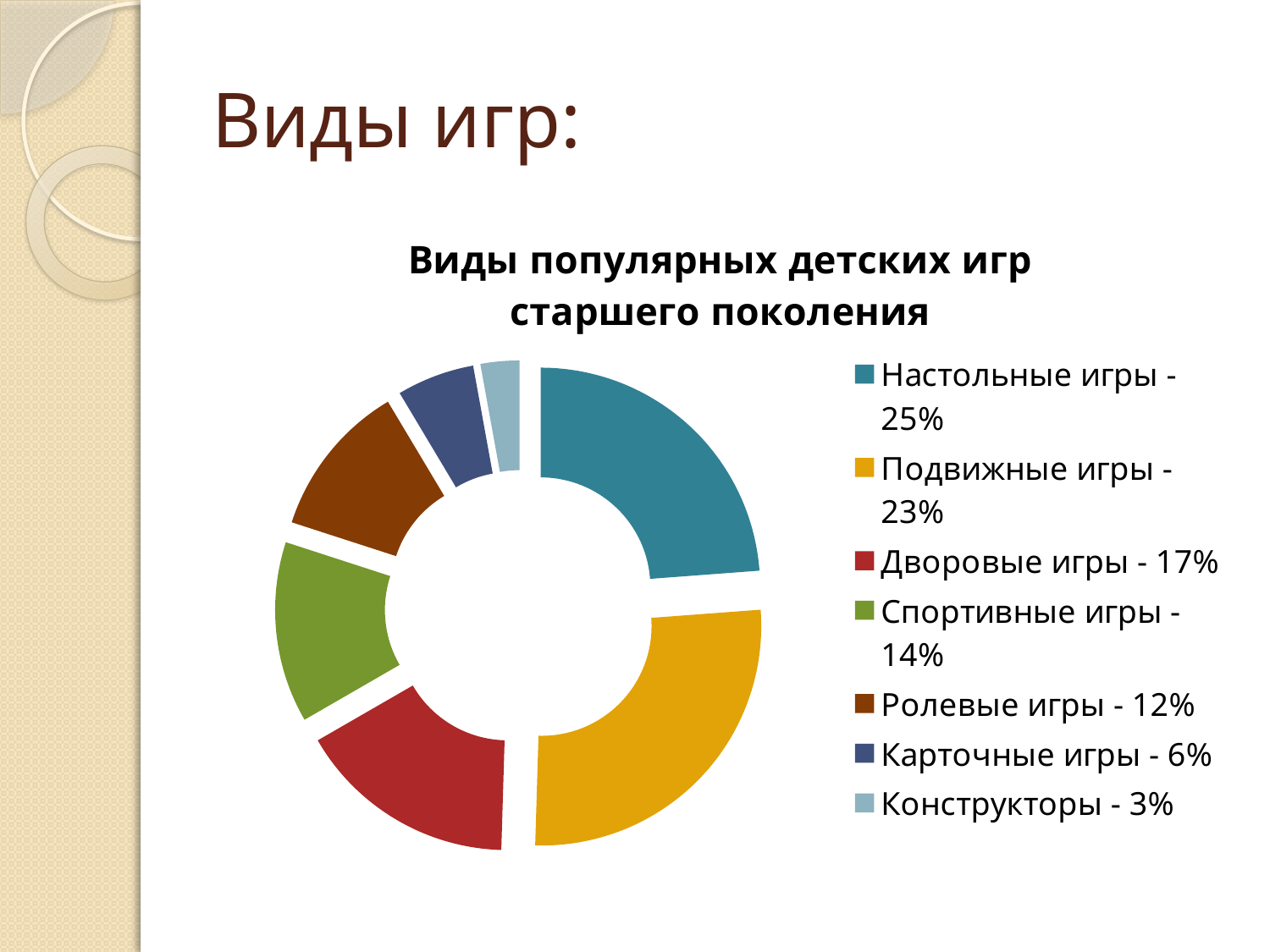
How many categories does the chart show? 7 What is the difference between Дворовые игры and Спортивные игры? 3% What share does Настольные игры have? 25% What is the difference between Настольные игры and Карточные игры? 19% Which category has the largest share? Настольные игры What is the value for Подвижные игры? 23% Which colour represents Спортивные игры in the chart? Green What type of chart is shown on the slide? Doughnut chart What is the value for Ролевые игры? 12% Which is larger, Карточные игры or Конструкторы? Карточные игры Which category has the smallest share? Конструкторы What is the title of the chart? Виды популярных детских игр старшего поколения